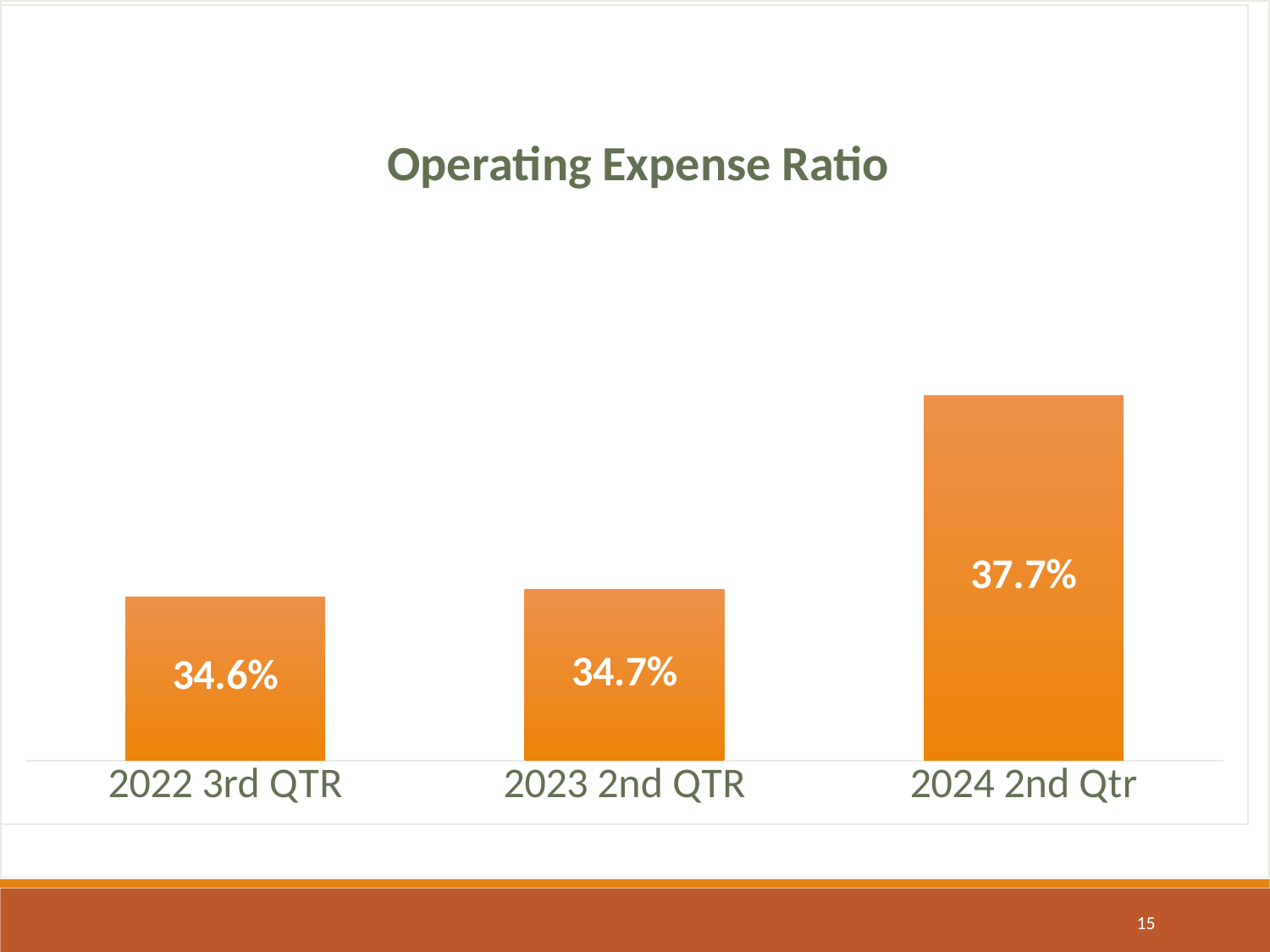
What kind of chart is shown on the slide? Bar chart Which is larger, the Operating Expense Ratio for 2024 2nd Qtr or for 2022 3rd QTR? 2024 2nd Qtr What is the Operating Expense Ratio for 2023 2nd QTR? 34.7% Which period has the lowest Operating Expense Ratio? 2022 3rd QTR What is the title of the chart? Operating Expense Ratio What is the Operating Expense Ratio for 2022 3rd QTR? 34.6% Which period has the highest Operating Expense Ratio? 2024 2nd Qtr What is the difference between the Operating Expense Ratio for 2024 2nd Qtr and 2023 2nd QTR? 3.0% What is the Operating Expense Ratio for 2024 2nd Qtr? 37.7% What is the difference between the Operating Expense Ratio for 2024 2nd Qtr and 2022 3rd QTR? 3.1% Do the Operating Expense Ratio values rise or fall from left to right across the periods? Rise How many periods are shown in the chart? 3